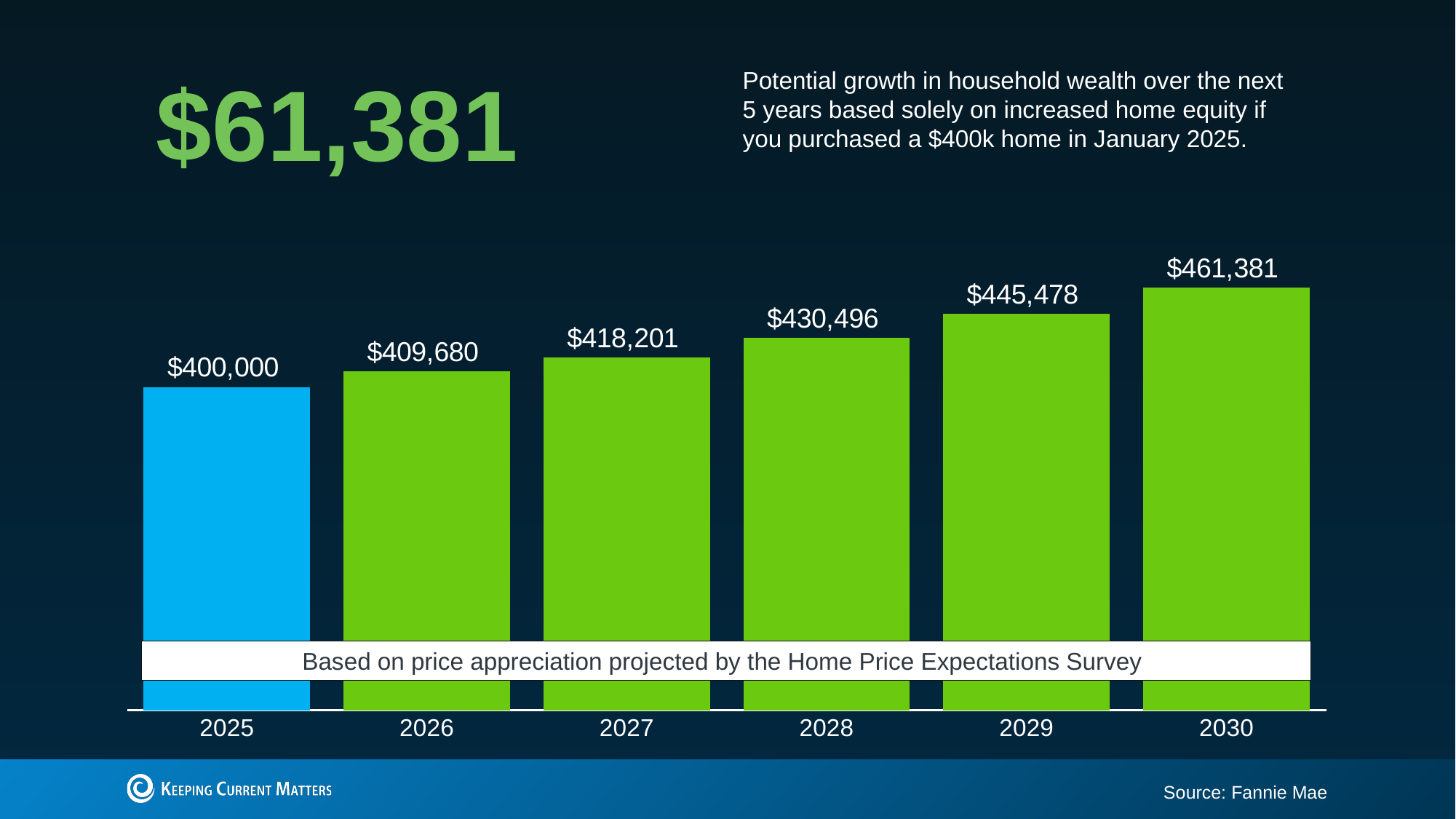
Do the values rise or fall from 2025 to 2030? Rise Which bar is coloured differently from the others? 2025 (blue) What is the difference between the 2030 value and the 2025 value? $61,381 What is the difference between the 2028 value and the 2027 value? $12,295 How many years are shown on the x axis? 6 What kind of chart is shown on the slide? Bar chart Which is larger, the value for 2026 or the value for 2028? 2028 What is the value shown for 2025? $400,000 Which year has the highest projected home value? 2030 What is the projected home value for 2029? $445,478 Which year has the lowest value on the chart? 2025 What is the projected home value for 2027? $418,201